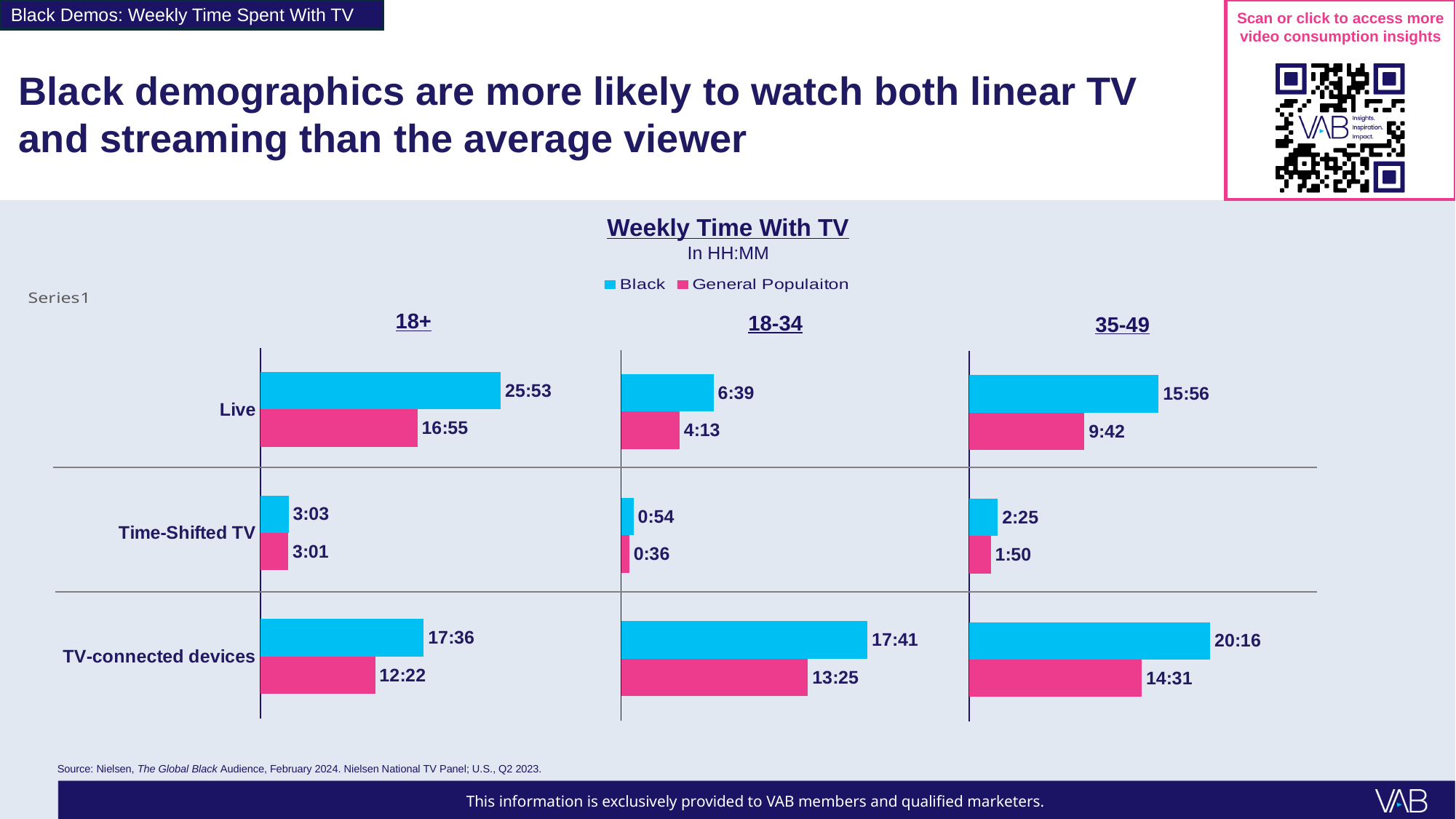
In the 18+ panel, what is the weekly time with Live TV for the Black audience? 25:53 How many series does the chart legend list? 2 In the 35-49 panel, what is the weekly time with Time-Shifted TV for the Black audience? 2:25 In the 35-49 panel, what is the difference between the Black and General Population values for TV-connected devices? 5:45 What unit does the chart subtitle say the values are in? HH:MM In the 18+ panel, what is the difference between the Black and General Population values for Live TV? 8:58 In the 35-49 panel, which is larger for Live TV: the Black value or the General Population value? Black What kind of chart is used to show Weekly Time With TV? Bar chart In the 18-34 panel, what is the weekly time with TV-connected devices for the General Population? 13:25 In the 18+ panel, which category has the highest value for the Black audience? Live In the 18-34 panel, which category has the lowest value for the General Population? Time-Shifted TV How many categories are shown on the vertical axis of the chart? 3